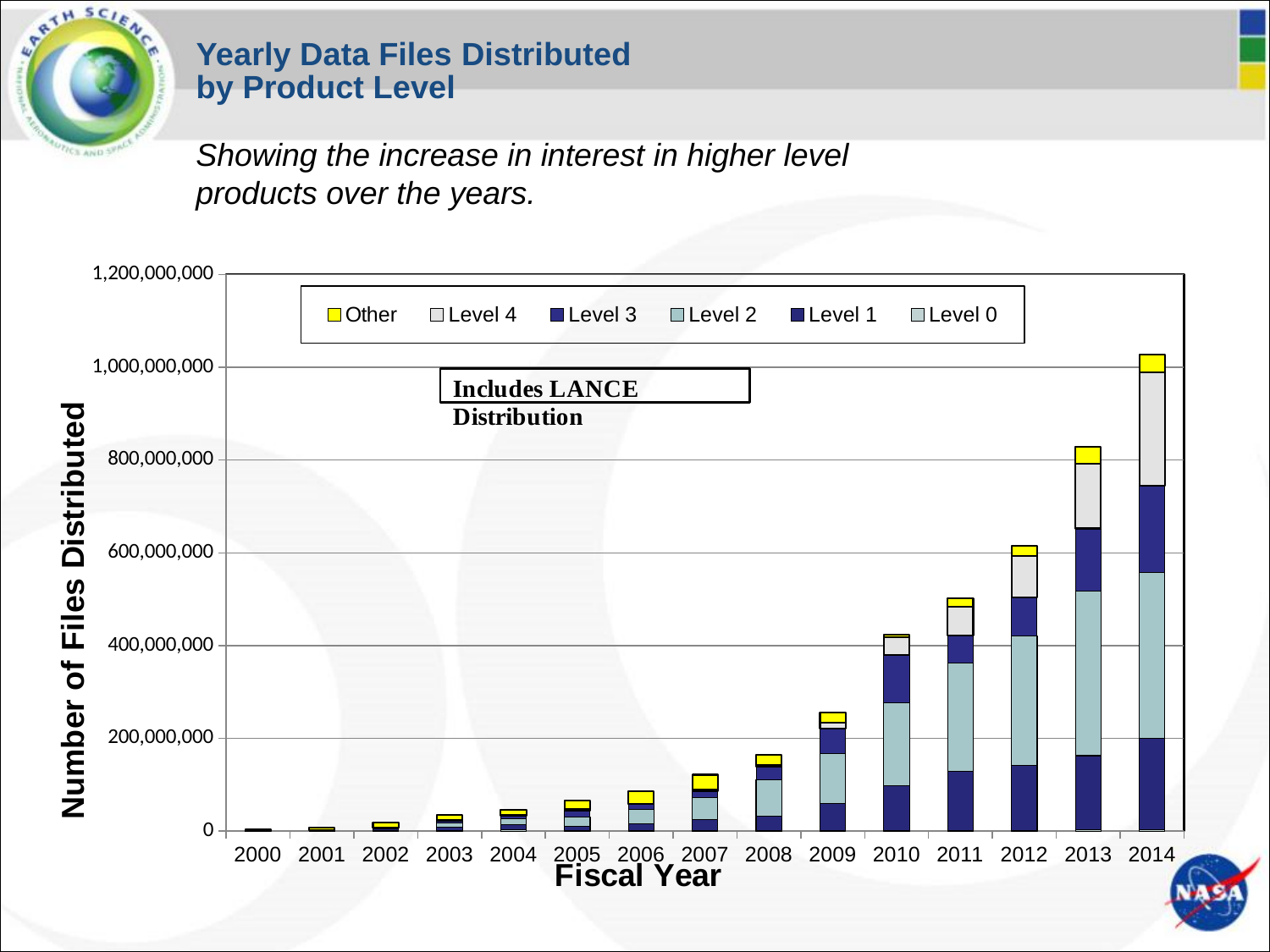
Which fiscal year has the lowest total number of files distributed? 2000 Is the total number of files distributed in 2014 greater or less than 800,000,000? greater Is the total number of files distributed in 2008 greater or less than 200,000,000? less Which fiscal year has the highest total number of files distributed? 2014 Do the total number of files distributed rise or fall from 2000 to 2014? Rise How many fiscal years are plotted along the x axis? 15 What is the label on the y axis of the chart? Number of Files Distributed What does the text box inside the chart area say? Includes LANCE Distribution How many series does the legend list? 6 What kind of chart is shown on the slide? Stacked bar chart Is the total number of files distributed in 2013 greater or less than 600,000,000? greater Which fiscal year has a larger total of files distributed, 2011 or 2009? 2011